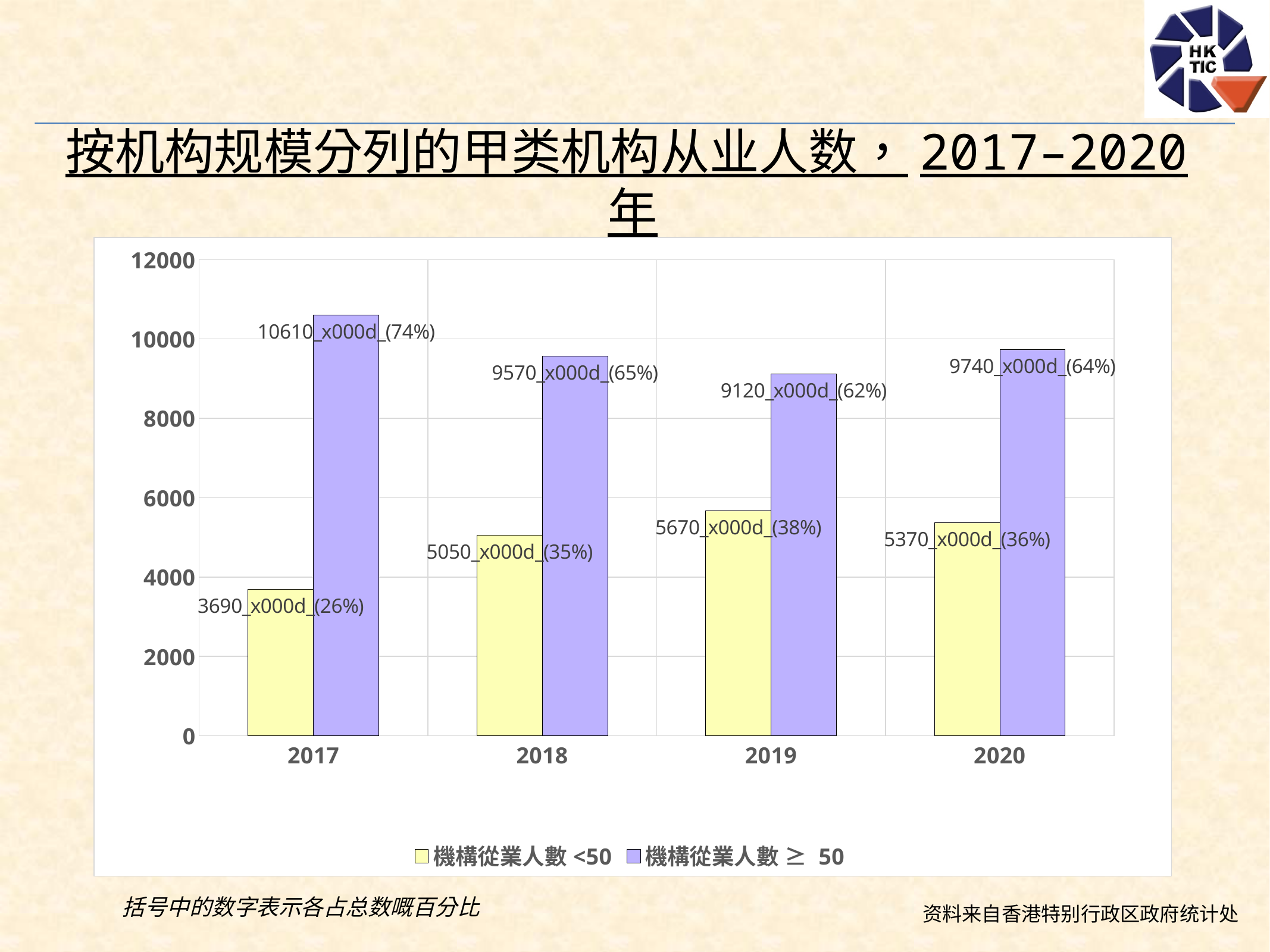
How many years are shown on the x axis? 4 What is the difference between the 機構從業人數 ≥ 50 value and the 機構從業人數 <50 value in 2019? 3450 What is the value for 機構從業人數 <50 in 2017? 3690 Which is larger in 2018: the value for 機構從業人數 <50 or for 機構從業人數 ≥ 50? 機構從業人數 ≥ 50 Which colour represents 機構從業人數 <50 in the legend? yellow How many series does the legend list? 2 What is the value for 機構從業人數 ≥ 50 in 2020? 9740 What percentage share is shown in parentheses for 機構從業人數 ≥ 50 in 2018? 65% What kind of chart is shown on the slide? bar chart Is the value for 機構從業人數 ≥ 50 in 2019 greater or less than 8000? greater In which year is the value for 機構從業人數 ≥ 50 the highest? 2017 In which year is the value for 機構從業人數 <50 the lowest? 2017